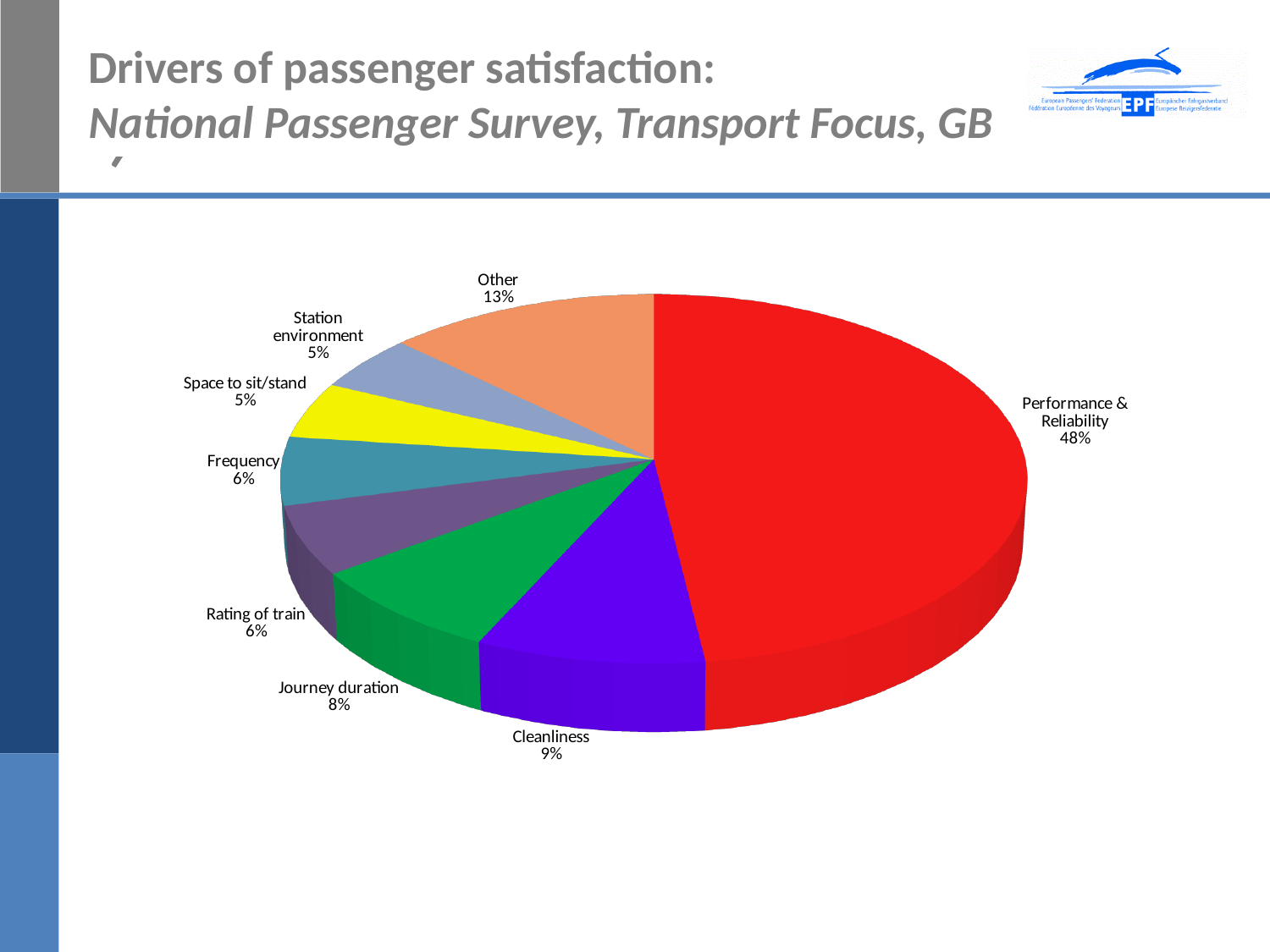
What colour is the Performance & Reliability slice? Red What is the value shown for Station environment? 5% What is the value shown for Journey duration? 8% What kind of chart is shown on the slide? Pie chart How many categories are shown in the pie chart? 8 What is the value shown for Frequency? 6% Which category has the largest slice of the pie? Performance & Reliability What share of the pie does Performance & Reliability account for? 48% Which is larger, Cleanliness or Journey duration? Cleanliness What is the value shown for Other? 13% What is the difference in percentage points between Performance & Reliability and Other? 35 What is the value shown for Cleanliness? 9%